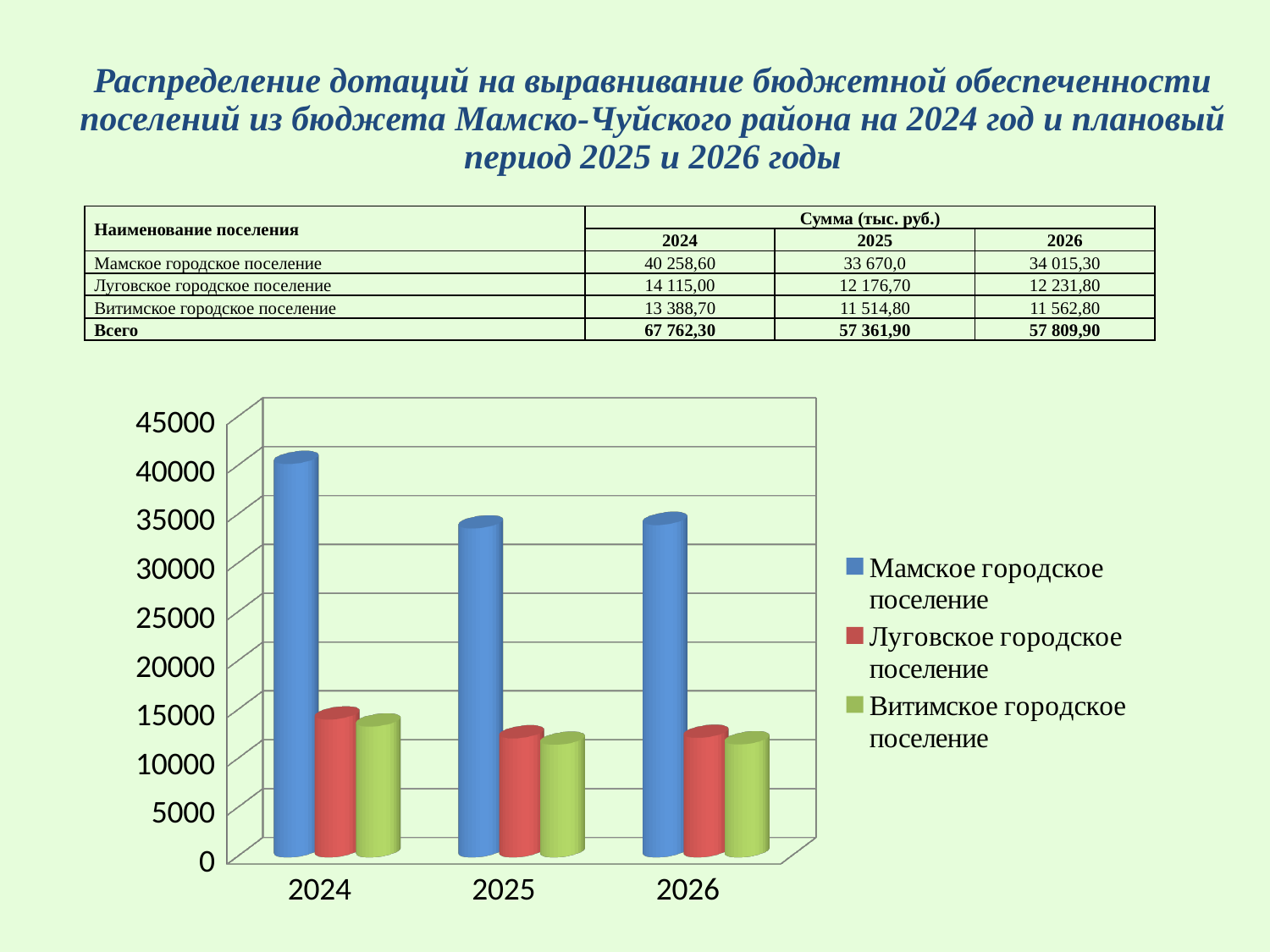
How many series does the chart legend list? 3 Which colour represents Витимское городское поселение in the chart? green Is the value for Луговское городское поселение in 2026 greater or less than 15000? less Which series has the lowest bar in 2025? Витимское городское поселение According to the table, what is the amount for Витимское городское поселение in 2026? 11 562,80 According to the table, what is the total (Всего) for 2024? 67 762,30 What kind of chart is shown on the slide? bar chart Does the bar for Мамское городское поселение rise or fall from 2024 to 2025? fall Which series has the highest bar in 2024? Мамское городское поселение Is the value for Мамское городское поселение in 2024 greater or less than 35000? greater According to the table, what is the amount for Мамское городское поселение in 2025? 33 670,0 How many year categories are shown on the x axis of the chart? 3